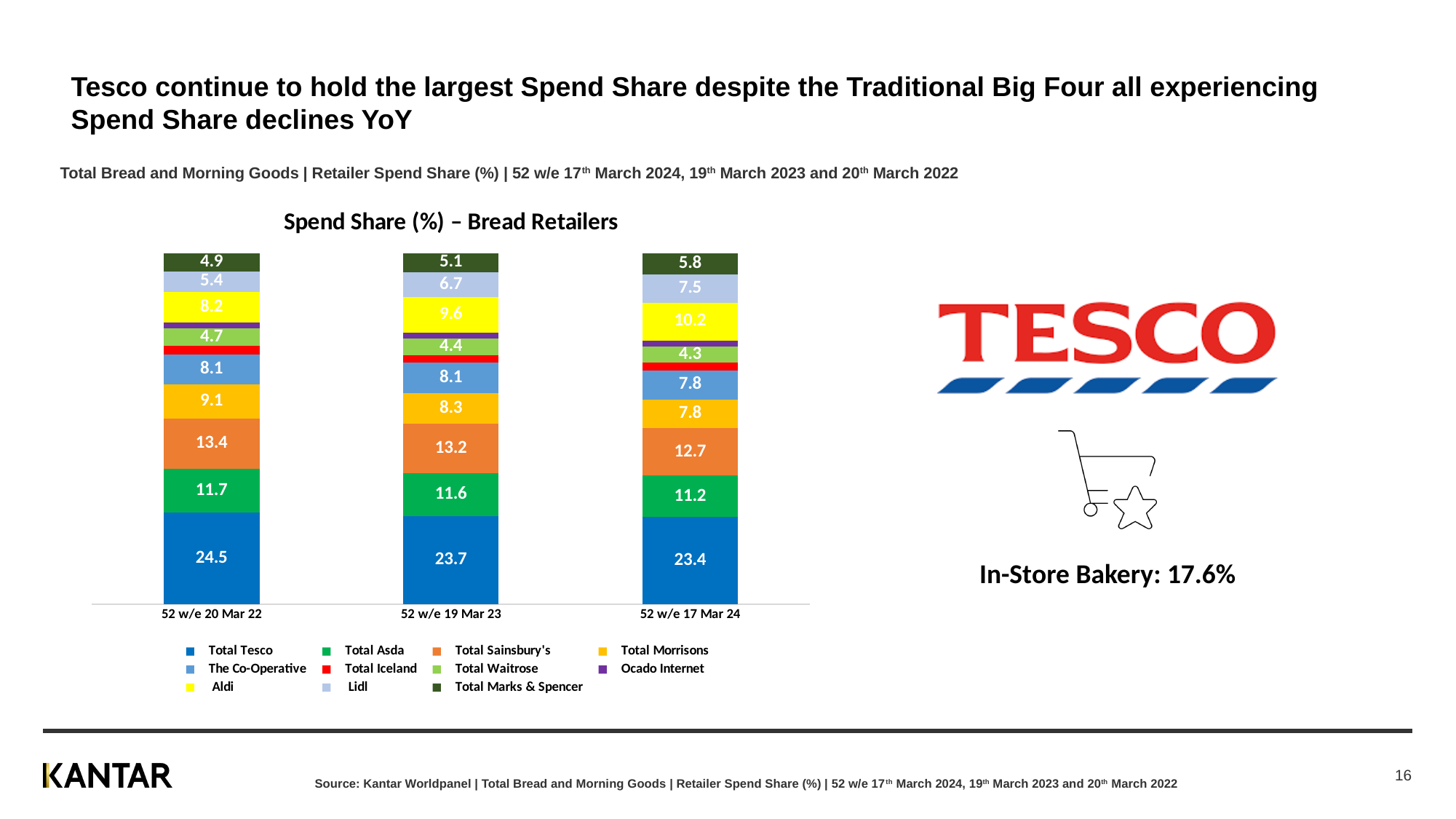
Which retailer has the largest spend share in the 52 w/e 17 Mar 24 bar? Total Tesco How many retailers does the chart legend list? 11 By how much did Aldi's spend share increase between 52 w/e 20 Mar 22 and 52 w/e 17 Mar 24? 2.0 By how much did Total Tesco's spend share fall between 52 w/e 20 Mar 22 and 52 w/e 17 Mar 24? 1.1 What is the spend share for Lidl in the 52 w/e 20 Mar 22 bar? 5.4 How many stacked bars (time periods) are shown in the chart? 3 In the 52 w/e 17 Mar 24 bar, which has the larger spend share: Lidl or Total Marks & Spencer? Lidl What is the spend share for Total Tesco in the 52 w/e 17 Mar 24 bar? 23.4 What is the spend share for Aldi in the 52 w/e 19 Mar 23 bar? 9.6 Does Aldi's spend share rise or fall across the three periods shown? rise What is the spend share for Total Sainsbury's in the 52 w/e 20 Mar 22 bar? 13.4 Does Total Tesco's spend share rise or fall across the three periods shown? fall